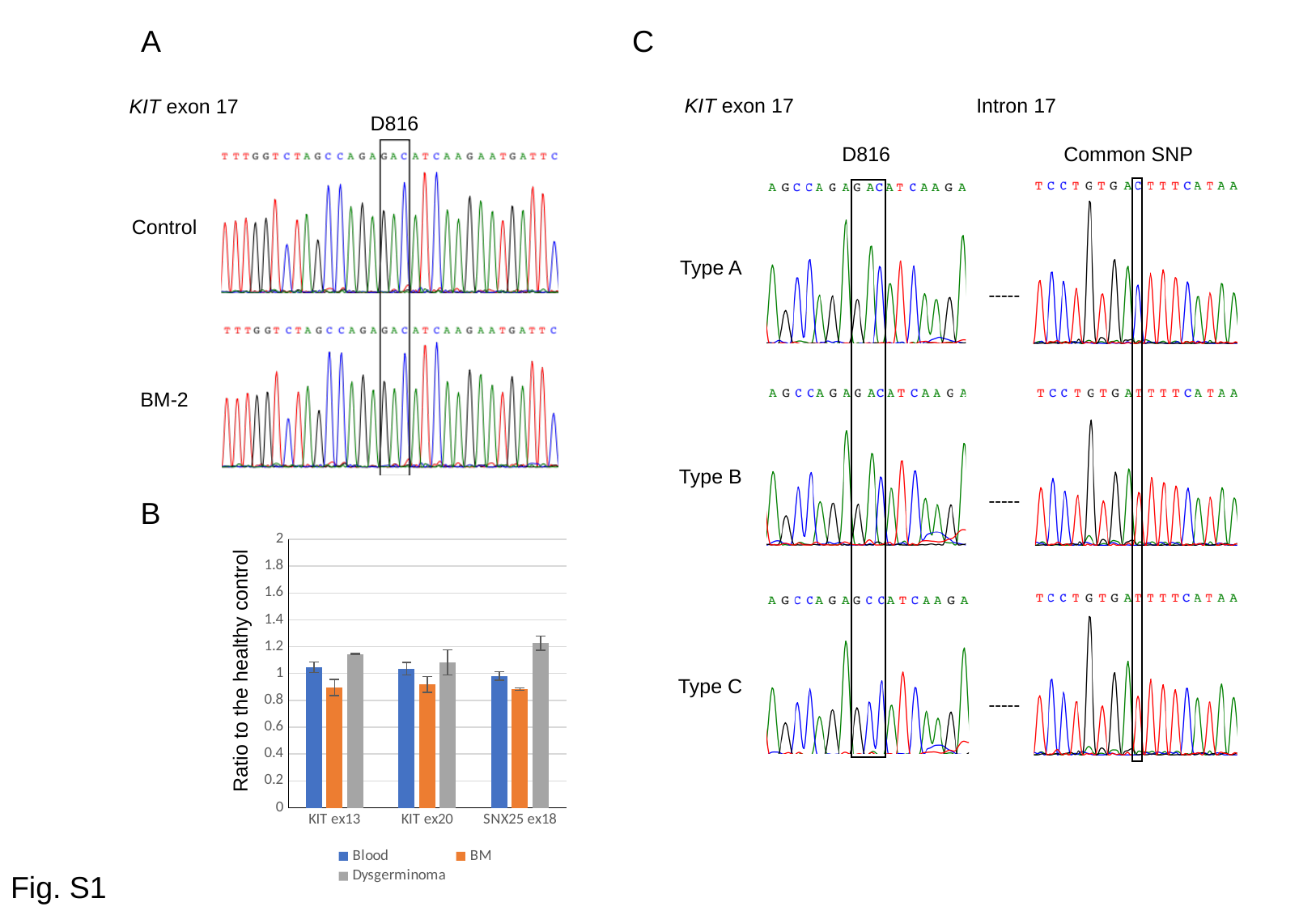
Which series are listed in the legend of the bar chart in panel B? Blood, BM, Dysgerminoma In the bar chart in panel B, which series has the highest value for SNX25 ex18? Dysgerminoma How many series does the legend of the bar chart in panel B list? 3 In the bar chart in panel B, for KIT ex13, which is larger: the Dysgerminoma value or the BM value? Dysgerminoma In the bar chart in panel B, is the Dysgerminoma value for SNX25 ex18 greater or less than 1? greater In the bar chart in panel B, which category has the highest Dysgerminoma value? SNX25 ex18 In the bar chart in panel B, which series has the lowest value for SNX25 ex18? BM What is the y-axis title of the bar chart in panel B? Ratio to the healthy control In the bar chart in panel B, is the Blood value for KIT ex13 greater or less than 1.2? less How many categories are shown on the x axis of the bar chart in panel B? 3 In the bar chart in panel B, is the BM value for KIT ex13 greater or less than 1? less What kind of chart is shown in panel B of the slide? bar chart